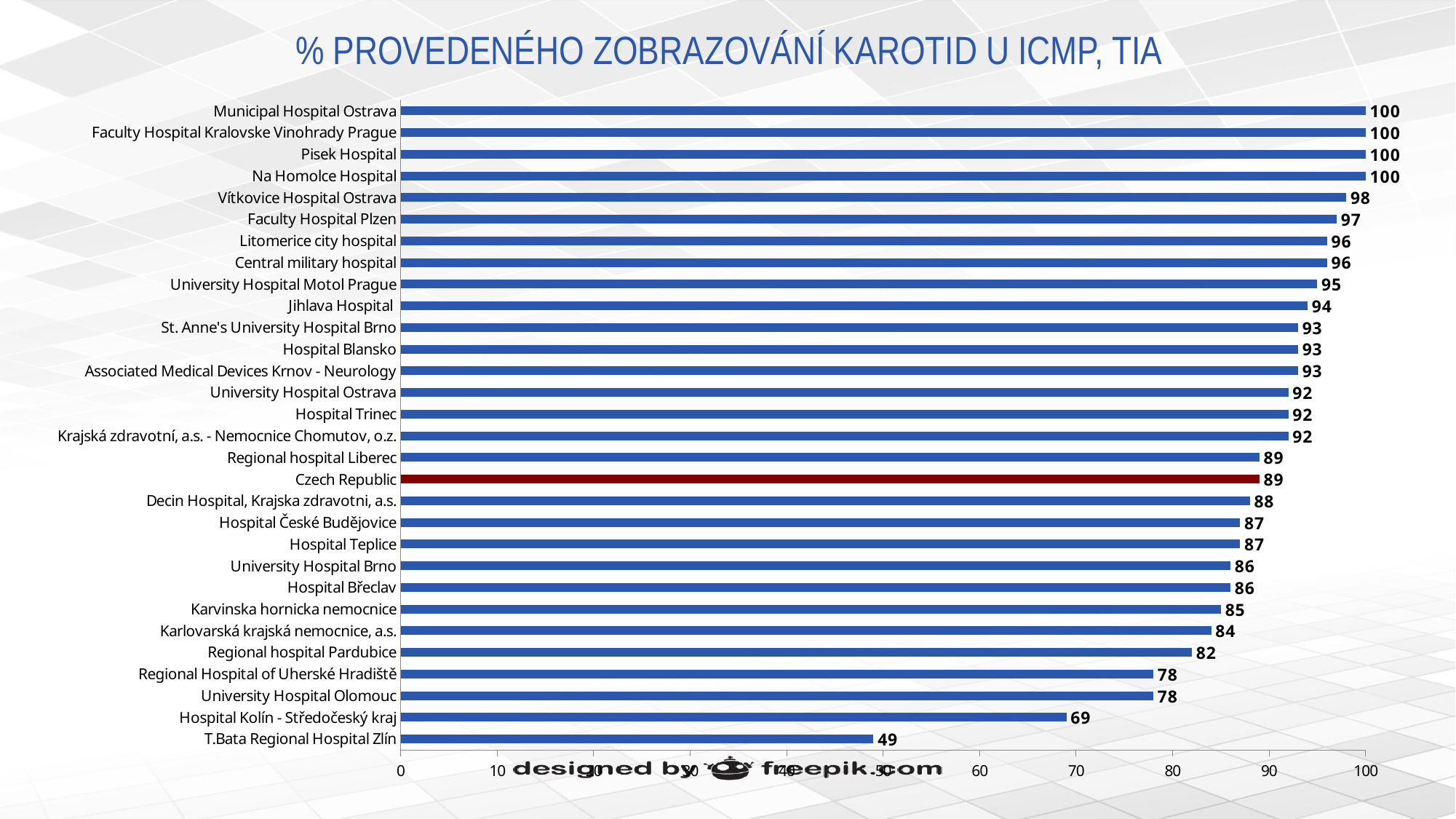
Which is larger, the value for Jihlava Hospital or the value for University Hospital Olomouc? Jihlava Hospital Which bar is shown in a different colour (dark red) from the others? Czech Republic What is the value for T.Bata Regional Hospital Zlín? 49 How many bars are shown in the chart? 30 Is the value for Hospital Kolín - Středočeský kraj greater or less than 80? less Which hospital has the lowest value? T.Bata Regional Hospital Zlín What is the value for Czech Republic? 89 What kind of chart is shown on the slide? bar chart What is the value for University Hospital Motol Prague? 95 What is the difference between the values for Vítkovice Hospital Ostrava and Regional hospital Pardubice? 16 What is the difference between the values for Czech Republic and T.Bata Regional Hospital Zlín? 40 What is the value for Hospital Kolín - Středočeský kraj? 69